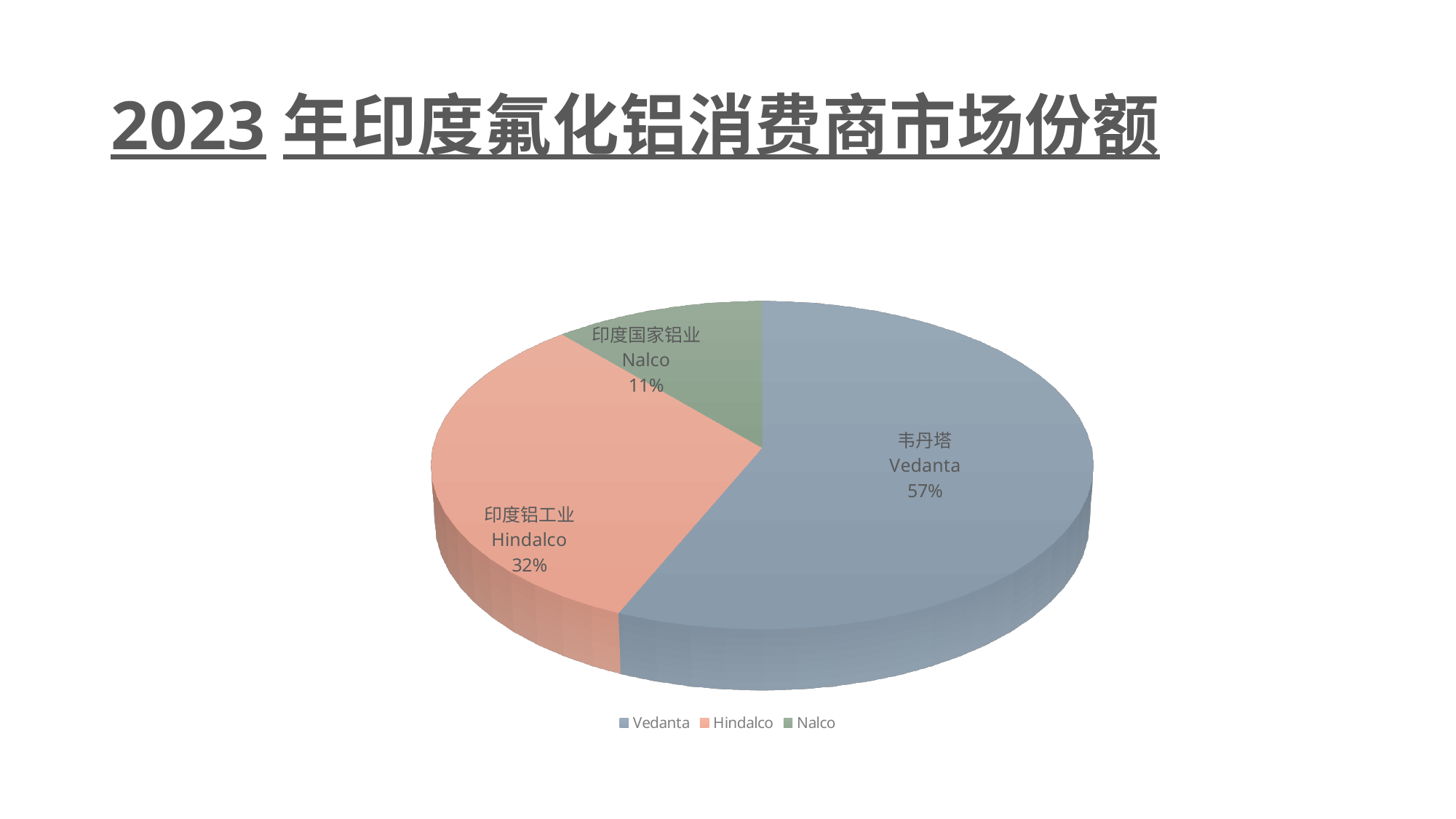
Which company has the largest market share? Vedanta Which has a larger market share, Hindalco or Nalco? Hindalco What is the difference in market share between Hindalco and Nalco? 21% What kind of chart is shown on the slide? Pie chart How many companies are shown in the pie chart? 3 What is the title of the slide? 2023 年印度氟化铝消费商市场份额 How many entries does the legend list? 3 What share of the pie does Vedanta hold? 57% What is the difference in market share between Vedanta and Hindalco? 25% What share of the pie does Hindalco hold? 32% What share of the pie does Nalco hold? 11% Which company has the smallest market share? Nalco